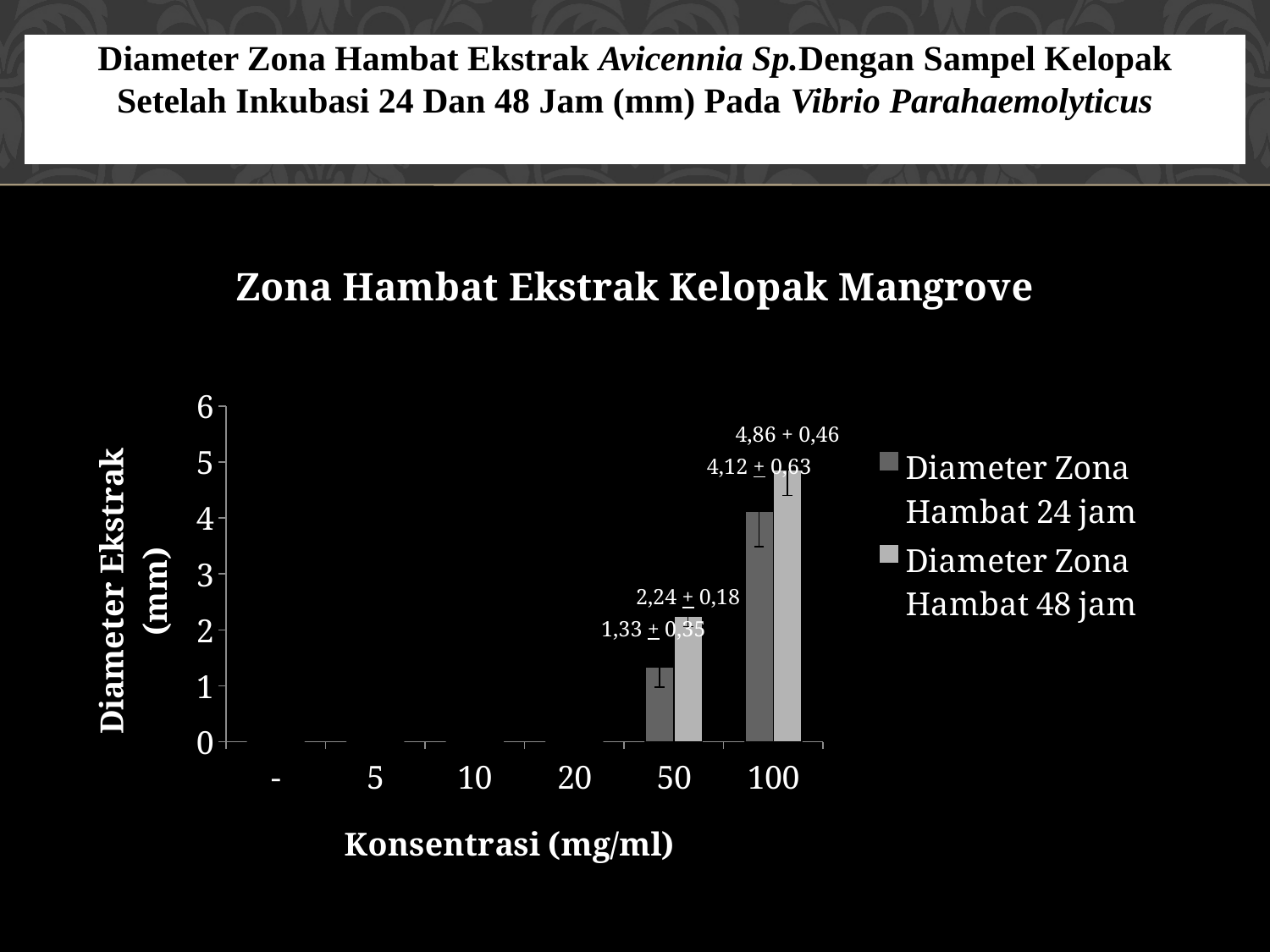
How many concentration categories are shown on the x axis? 6 What kind of chart is shown on the slide? bar chart What is the mean diameter for Diameter Zona Hambat 24 jam at a concentration of 50 mg/ml? 1,33 How many series does the legend list? 2 What is the mean diameter for Diameter Zona Hambat 48 jam at a concentration of 100 mg/ml? 4,86 What is the mean diameter for Diameter Zona Hambat 48 jam at a concentration of 50 mg/ml? 2,24 At 100 mg/ml, which series has the larger value: Diameter Zona Hambat 24 jam or Diameter Zona Hambat 48 jam? Diameter Zona Hambat 48 jam What is the mean diameter for Diameter Zona Hambat 24 jam at a concentration of 100 mg/ml? 4,12 What is the title of the chart? Zona Hambat Ekstrak Kelopak Mangrove What is the difference between the mean Diameter Zona Hambat 48 jam and 24 jam values at 100 mg/ml? 0,74 Is the Diameter Zona Hambat 24 jam value at 100 mg/ml greater or less than 3? greater Which concentration has the highest Diameter Zona Hambat 48 jam value? 100